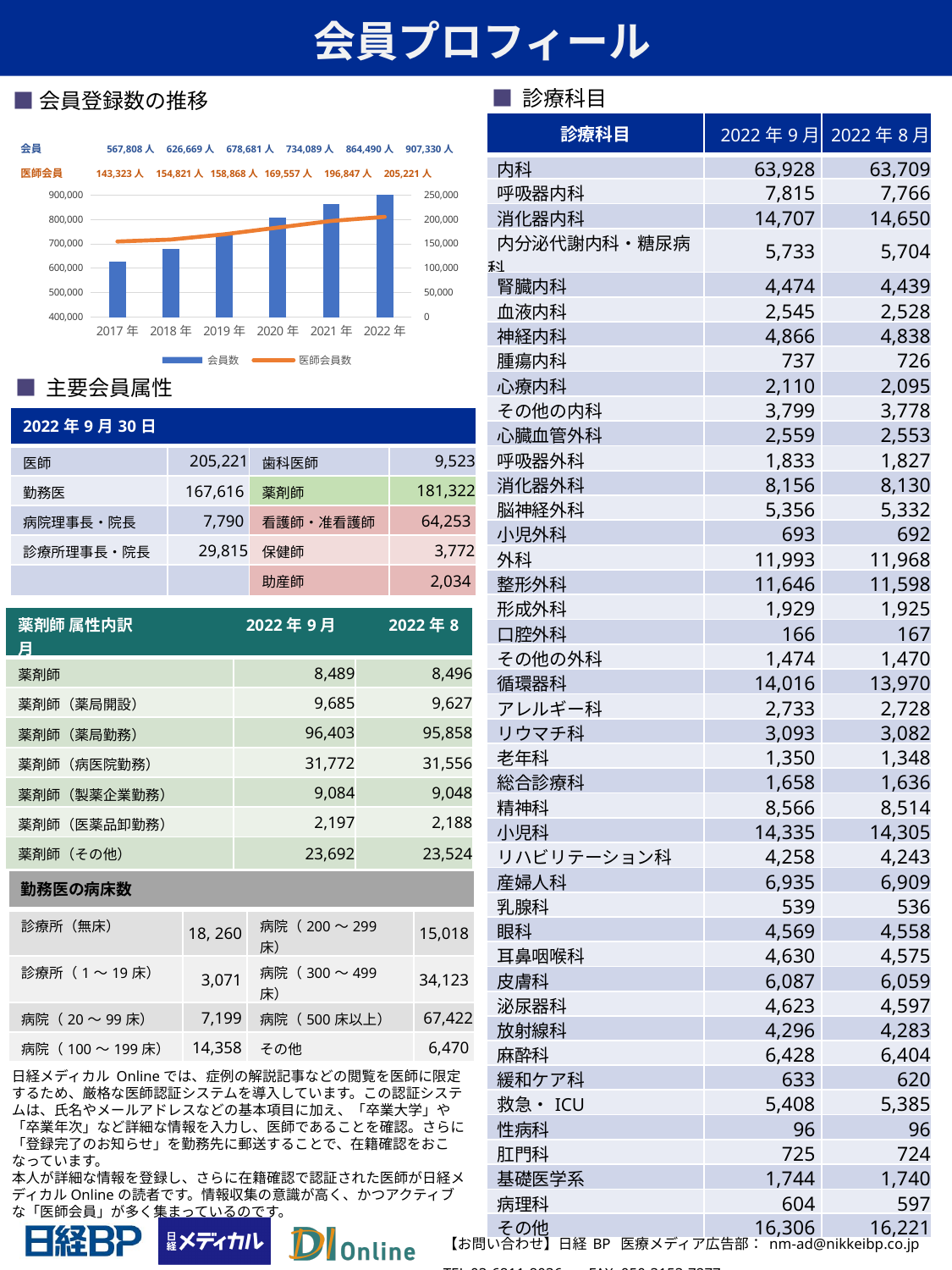
In the 会員登録数の推移 chart, how many series does the legend list? 2 In the 会員登録数の推移 chart, what is the difference between the 会員 values for 2022年 and 2021年? 42,840人 In the 会員登録数の推移 chart, what is the 会員 value for 2022年? 907,330人 In the 会員登録数の推移 chart, is the 会員 value for 2020年 larger than the 会員 value for 2018年? Yes In the 会員登録数の推移 chart, which series is drawn as a line? 医師会員数 In the 会員登録数の推移 chart, what is the 医師会員 value for 2021年? 196,847人 In the 会員登録数の推移 chart, which year has the lowest 医師会員 value? 2017年 In the 会員登録数の推移 chart, do the 会員 values rise or fall from 2017年 to 2022年? Rise In the 会員登録数の推移 chart, how many years are shown on the x axis? 6 In the 会員登録数の推移 chart, which year has the highest 会員 value? 2022年